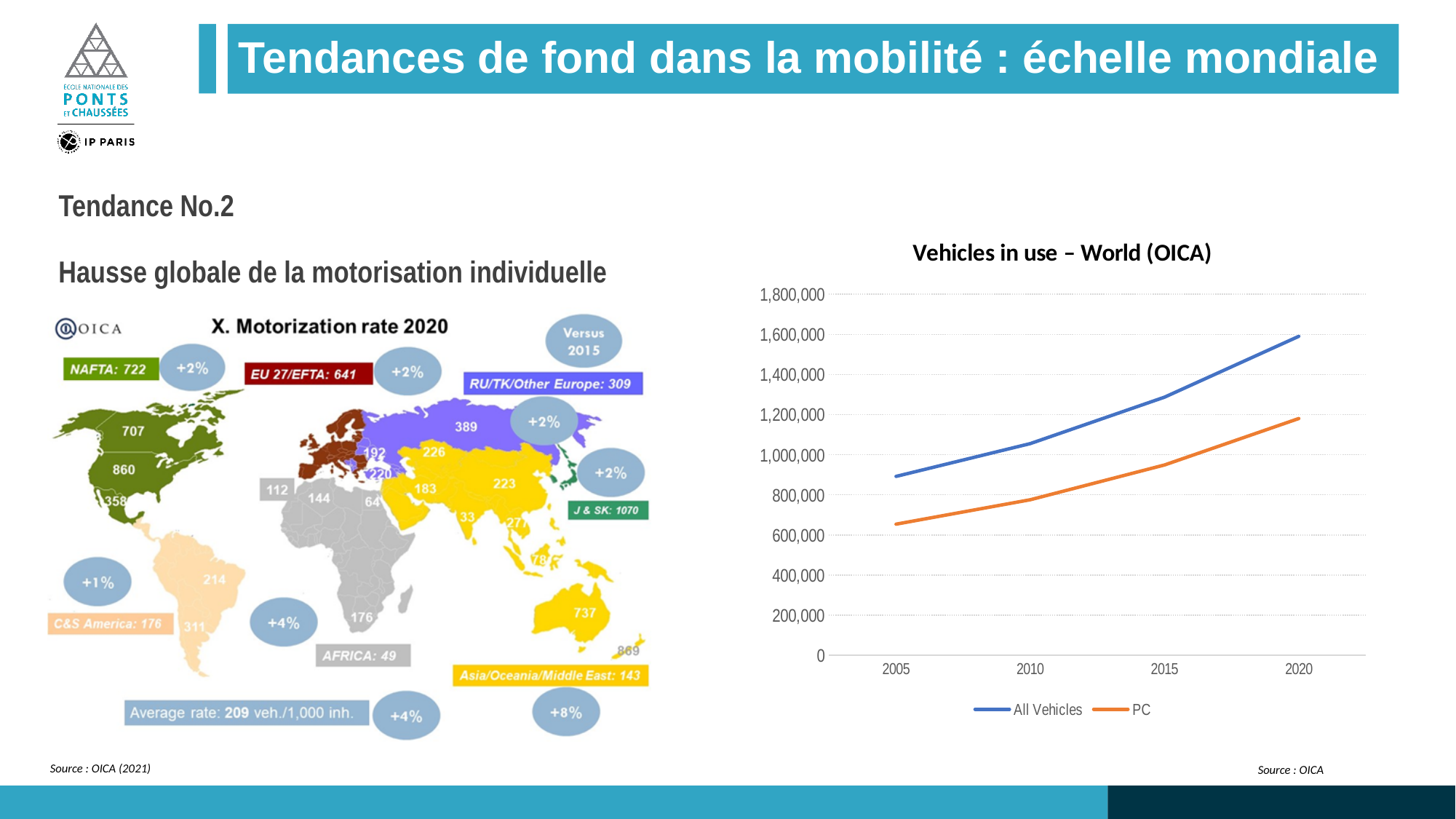
How many years are shown on the x axis of the 'Vehicles in use – World (OICA)' chart? 4 In the 'Vehicles in use – World (OICA)' chart, is the PC value for 2020 greater or less than 1,000,000? greater In the 'Vehicles in use – World (OICA)' chart, do the All Vehicles values rise or fall from 2005 to 2020? rise What kind of chart is 'Vehicles in use – World (OICA)'? line chart In the 'Vehicles in use – World (OICA)' chart, is the PC value for 2005 greater or less than 800,000? less In the 'Vehicles in use – World (OICA)' chart, is the All Vehicles value for 2020 greater or less than 1,400,000? greater In the 'Vehicles in use – World (OICA)' chart, which series is higher in 2020, All Vehicles or PC? All Vehicles In the 'Vehicles in use – World (OICA)' chart, in which year is the All Vehicles value highest? 2020 In the 'Vehicles in use – World (OICA)' chart, what colour is the PC line? orange How many series does the legend of the 'Vehicles in use – World (OICA)' chart list? 2 In the 'Vehicles in use – World (OICA)' chart, in which year is the PC value lowest? 2005